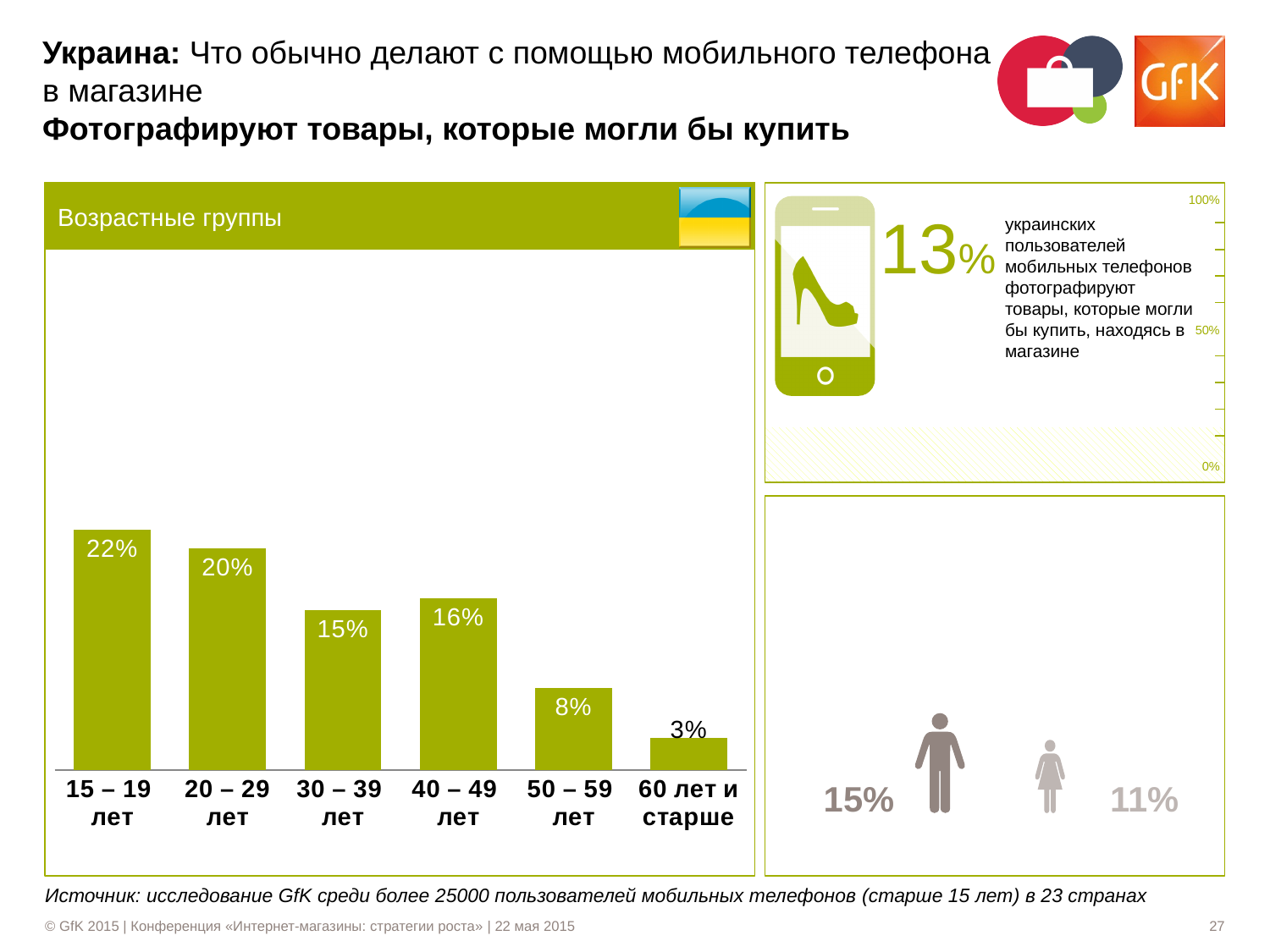
In the 'Возрастные группы' bar chart, what is the difference between the values for 20 – 29 лет and 50 – 59 лет? 12% In the 'Возрастные группы' bar chart, which age group has the lowest value? 60 лет и старше In the 'Возрастные группы' bar chart, do the values generally rise or fall from the youngest to the oldest age group? Fall In the 'Возрастные группы' bar chart, which is larger: the value for 30 – 39 лет or for 40 – 49 лет? 40 – 49 лет In the gender infographic at the bottom right of the slide, what is the value shown for men? 15% In the 'Возрастные группы' bar chart, what is the value for the 15 – 19 лет group? 22% In the 'Возрастные группы' bar chart, what is the value for the 50 – 59 лет group? 8% How many age groups are shown in the 'Возрастные группы' bar chart? 6 In the 'Возрастные группы' bar chart, which age group has the highest value? 15 – 19 лет What kind of chart is the 'Возрастные группы' chart? Bar chart In the chart at the top right of the slide, what percentage of Ukrainian mobile phone users photograph goods they might buy while in a store? 13% In the 'Возрастные группы' bar chart, what is the value for the 60 лет и старше group? 3%